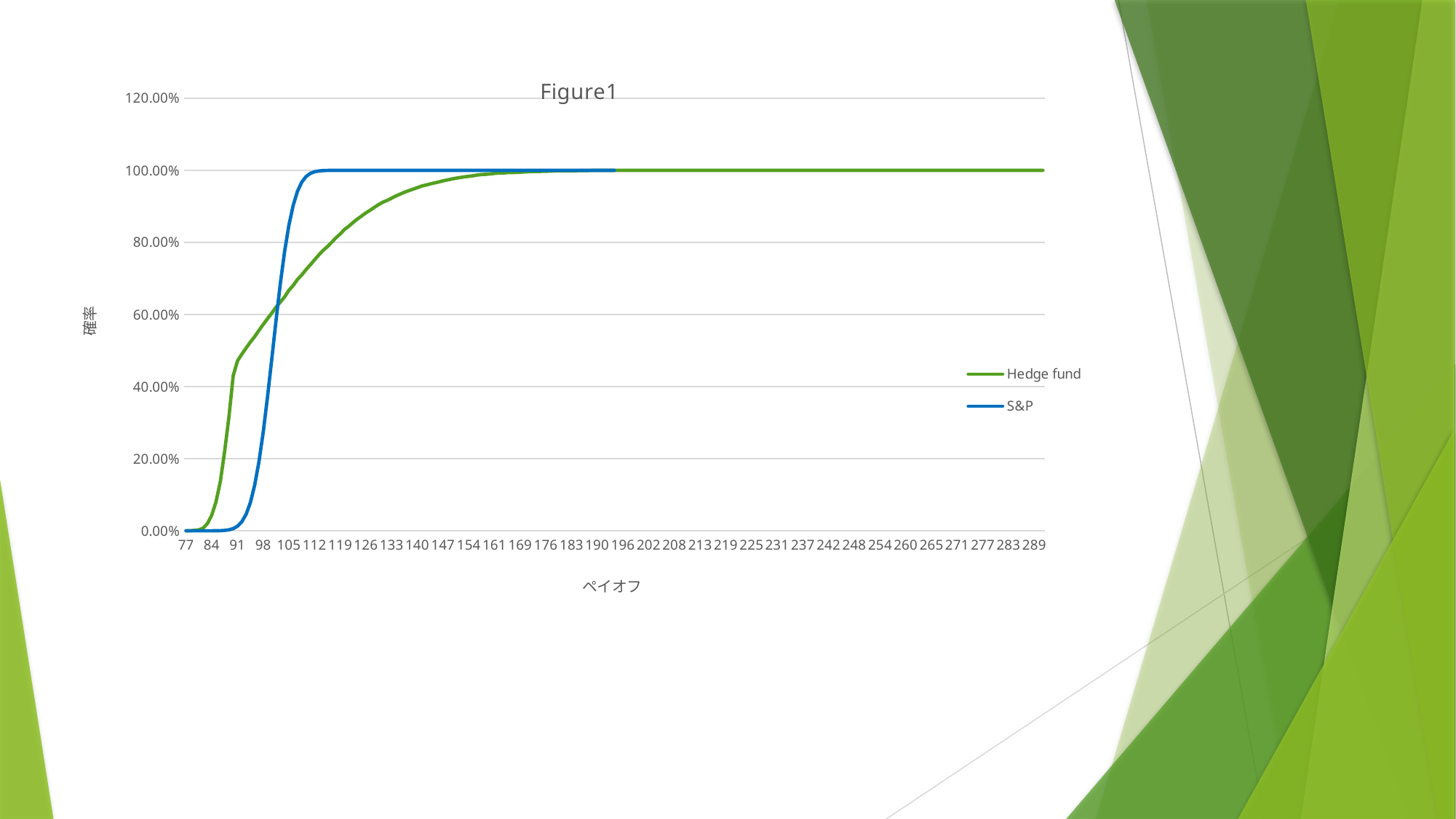
What is the value for Hedge fund at a payoff of 289? 100.00% How many series does the legend list? 2 What kind of chart is shown on the slide? line chart Do the values for Hedge fund rise or fall as the payoff increases along the x axis? rise Which series is drawn in blue? S&P At a payoff of 91, is the value for Hedge fund greater or less than 40.00%? greater At a payoff of 91, is the value for S&P greater or less than 20.00%? less At a payoff of 112, which series has the higher value, Hedge fund or S&P? S&P At a payoff of 91, which series has the higher value, Hedge fund or S&P? Hedge fund What is the title of the chart? Figure1 At a payoff of 133, is the value for Hedge fund greater or less than 80.00%? greater